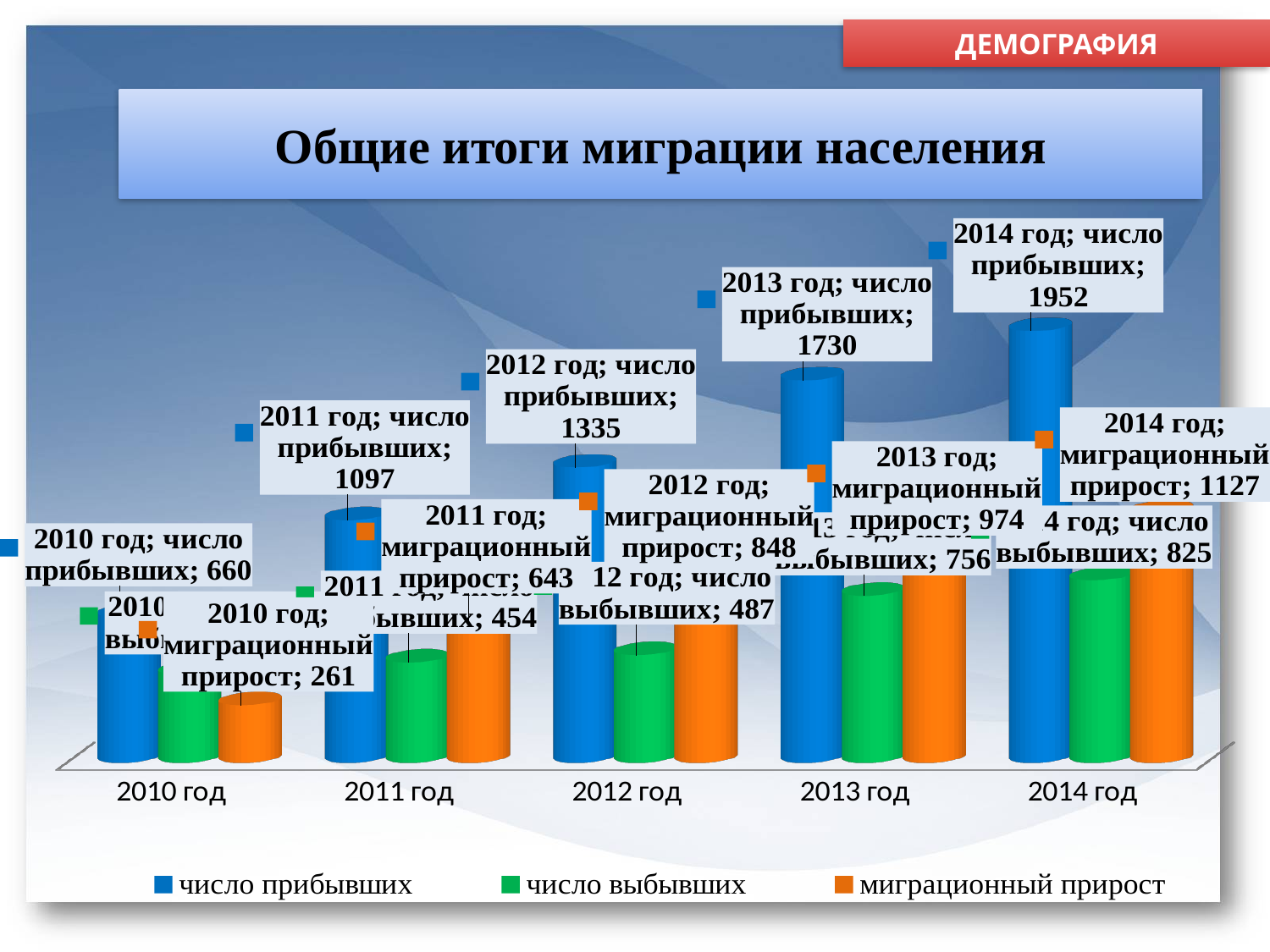
By how much does число прибывших in 2014 год exceed that in 2013 год? 222 Does число прибывших rise or fall from 2010 год to 2014 год? rise Which is larger: число выбывших in 2011 год or in 2012 год? 2012 год What is the число выбывших for 2013 год? 756 What is the value of число прибывших for 2014 год? 1952 How many series does the legend list? 3 How many years are shown on the x axis? 5 What is the миграционный прирост for 2010 год? 261 What is the миграционный прирост for 2012 год? 848 Which year has the highest число прибывших? 2014 год What kind of chart is shown on the slide? bar chart Which year has the lowest число прибывших? 2010 год